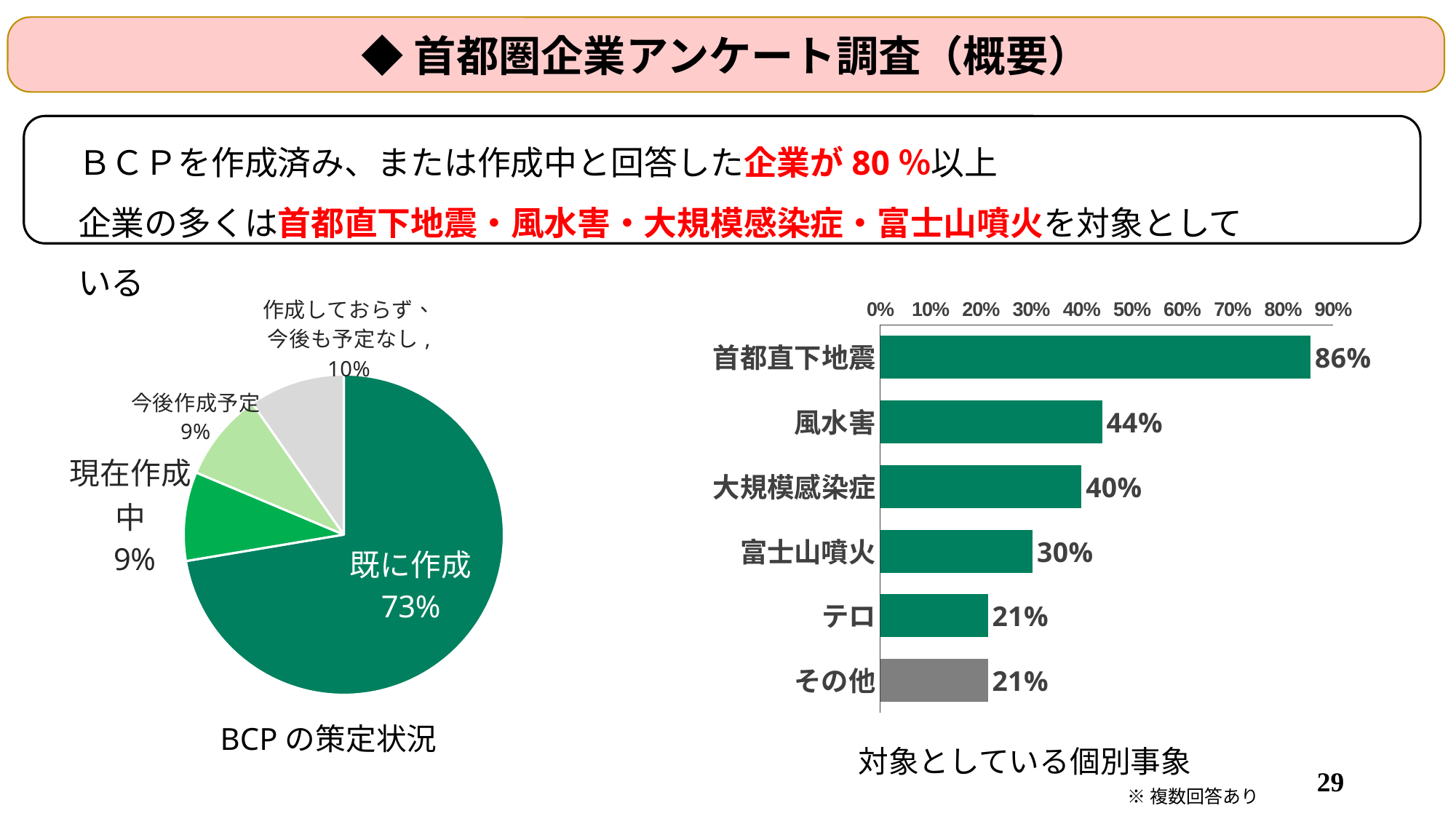
In the bar chart '対象としている個別事象', which is larger, 風水害 or 大規模感染症? 風水害 In the pie chart 'BCPの策定状況', which category has the largest slice? 既に作成 In the bar chart '対象としている個別事象', what is the difference between 首都直下地震 and 大規模感染症? 46% What kind of chart is the chart on the left of the slide? Pie chart In the bar chart '対象としている個別事象', what is the value for 富士山噴火? 30% What kind of chart is the chart on the right of the slide? Bar chart In the bar chart '対象としている個別事象', what is the value for 風水害? 44% In the pie chart 'BCPの策定状況', how many slices are there? 4 In the bar chart '対象としている個別事象', how many categories are shown? 6 In the pie chart 'BCPの策定状況', what share is labelled for 作成しておらず、今後も予定なし? 10% In the bar chart '対象としている個別事象', which category has the highest value? 首都直下地震 In the pie chart 'BCPの策定状況', what share is labelled for 既に作成? 73%